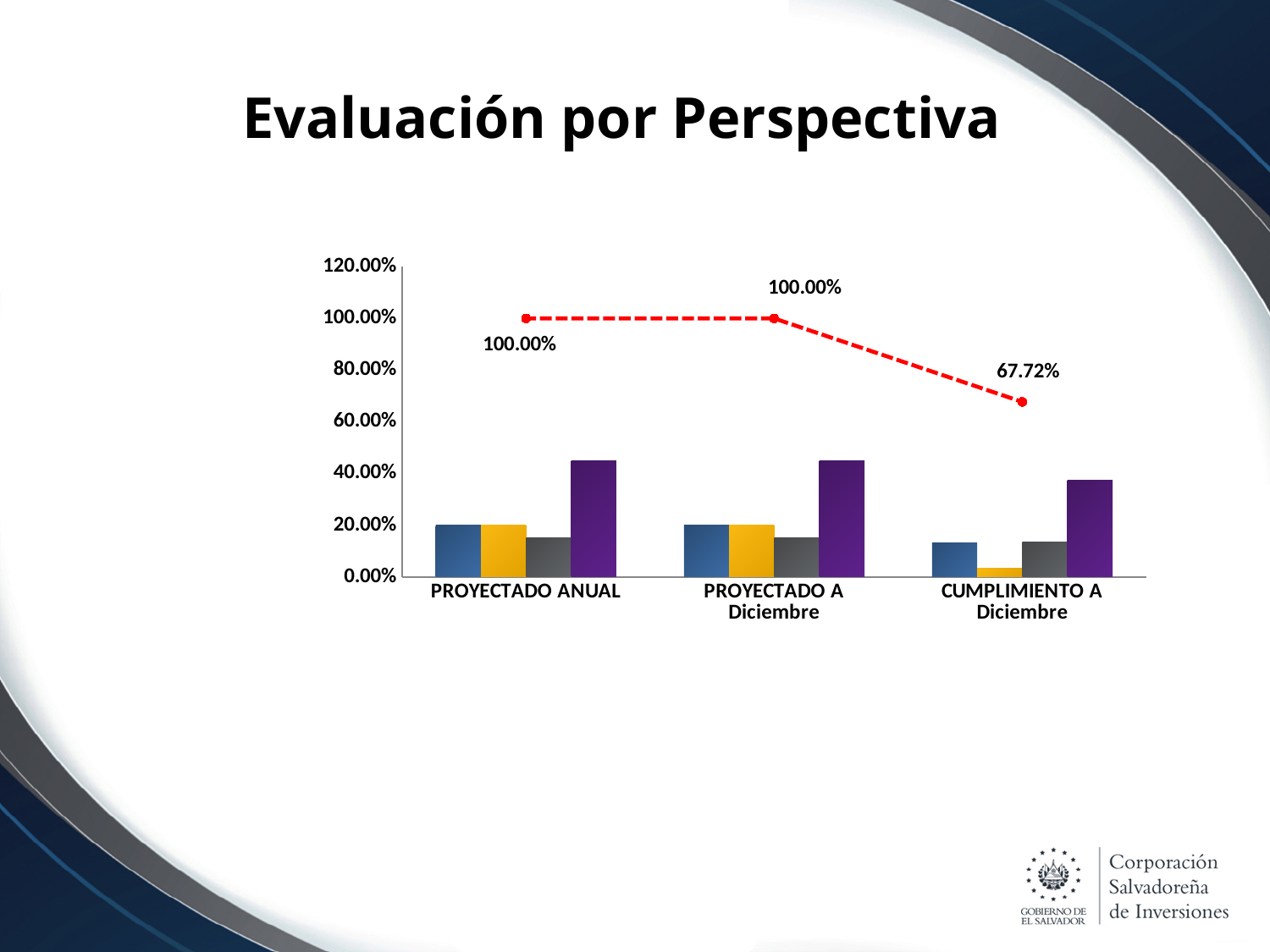
Does the red dashed line rise or fall from PROYECTADO A Diciembre to CUMPLIMIENTO A Diciembre? falls At which category does the red dashed line have its lowest value? CUMPLIMIENTO A Diciembre Which coloured bar is the tallest in the PROYECTADO ANUAL group? purple What is the value of the red dashed line at PROYECTADO A Diciembre? 100.00% What is the value of the red dashed line at CUMPLIMIENTO A Diciembre? 67.72% What is the value of the red dashed line at PROYECTADO ANUAL? 100.00% Is the yellow bar for CUMPLIMIENTO A Diciembre greater or less than 20.00%? less Is the purple bar for PROYECTADO ANUAL greater or less than 60.00%? less What is the difference between the red line's value at PROYECTADO A Diciembre and at CUMPLIMIENTO A Diciembre? 32.28% What is the title of the slide containing the chart? Evaluación por Perspectiva In the CUMPLIMIENTO A Diciembre group, which is larger: the purple bar or the blue bar? the purple bar How many categories are shown on the x axis? 3